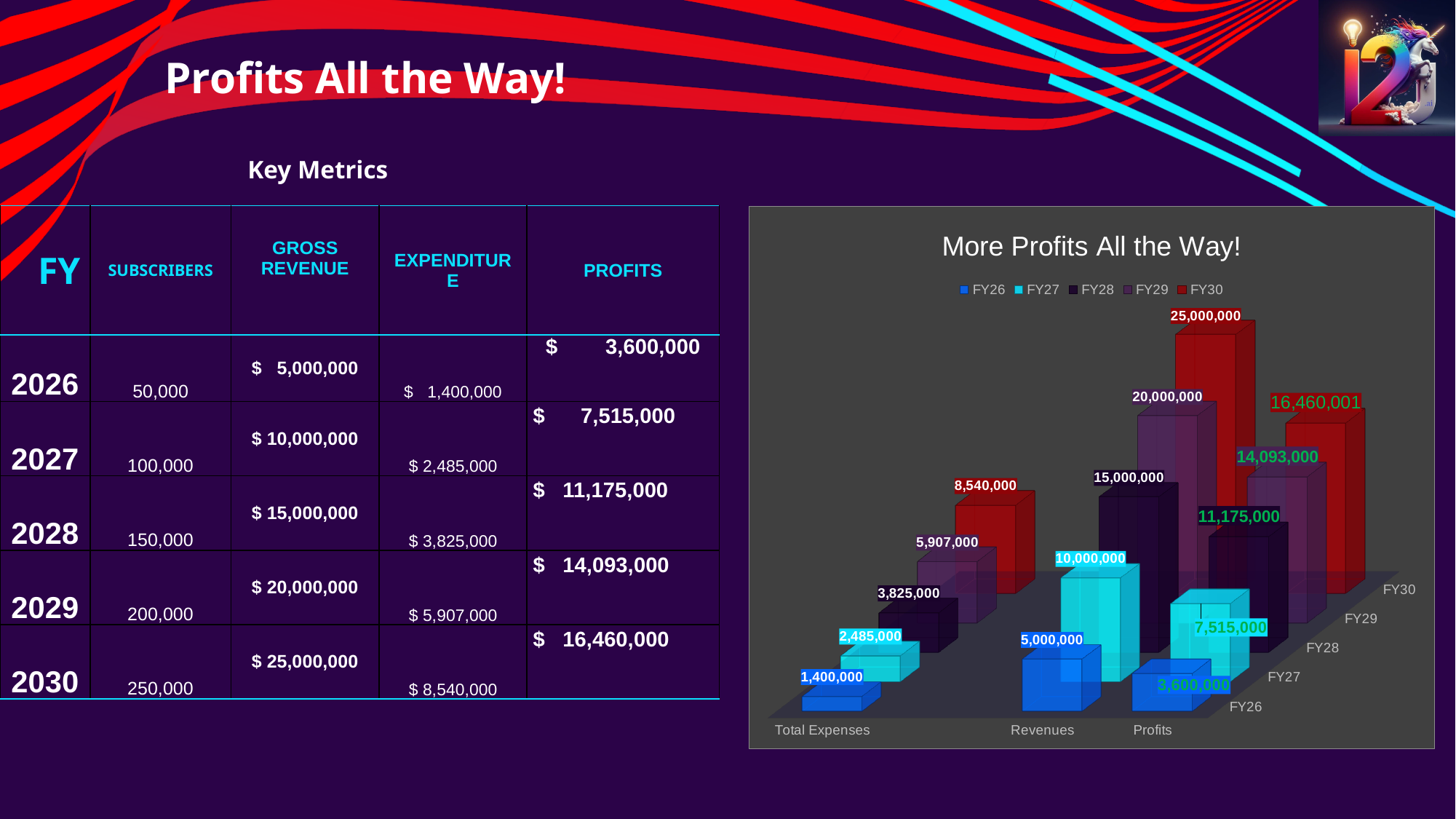
What is the FY30 value for Revenues in the chart? 25,000,000 Which is larger in the chart: the FY29 Profits value or the FY29 Total Expenses value? FY29 Profits What is the FY28 value for Total Expenses in the chart? 3,825,000 Do the Profits values rise or fall from FY26 to FY30 in the chart? rise How many categories are shown along the x axis of the chart? 3 Which fiscal year has the lowest Total Expenses value in the chart? FY26 What is the difference between the FY27 Revenues value and the FY27 Total Expenses value in the chart? 7,515,000 What is the FY30 value for Profits as labelled in the chart? 16,460,001 What is the title of the chart? More Profits All the Way! How many series does the chart legend list? 5 Which fiscal year has the highest Revenues value in the chart? FY30 What kind of chart is shown on the slide? bar chart